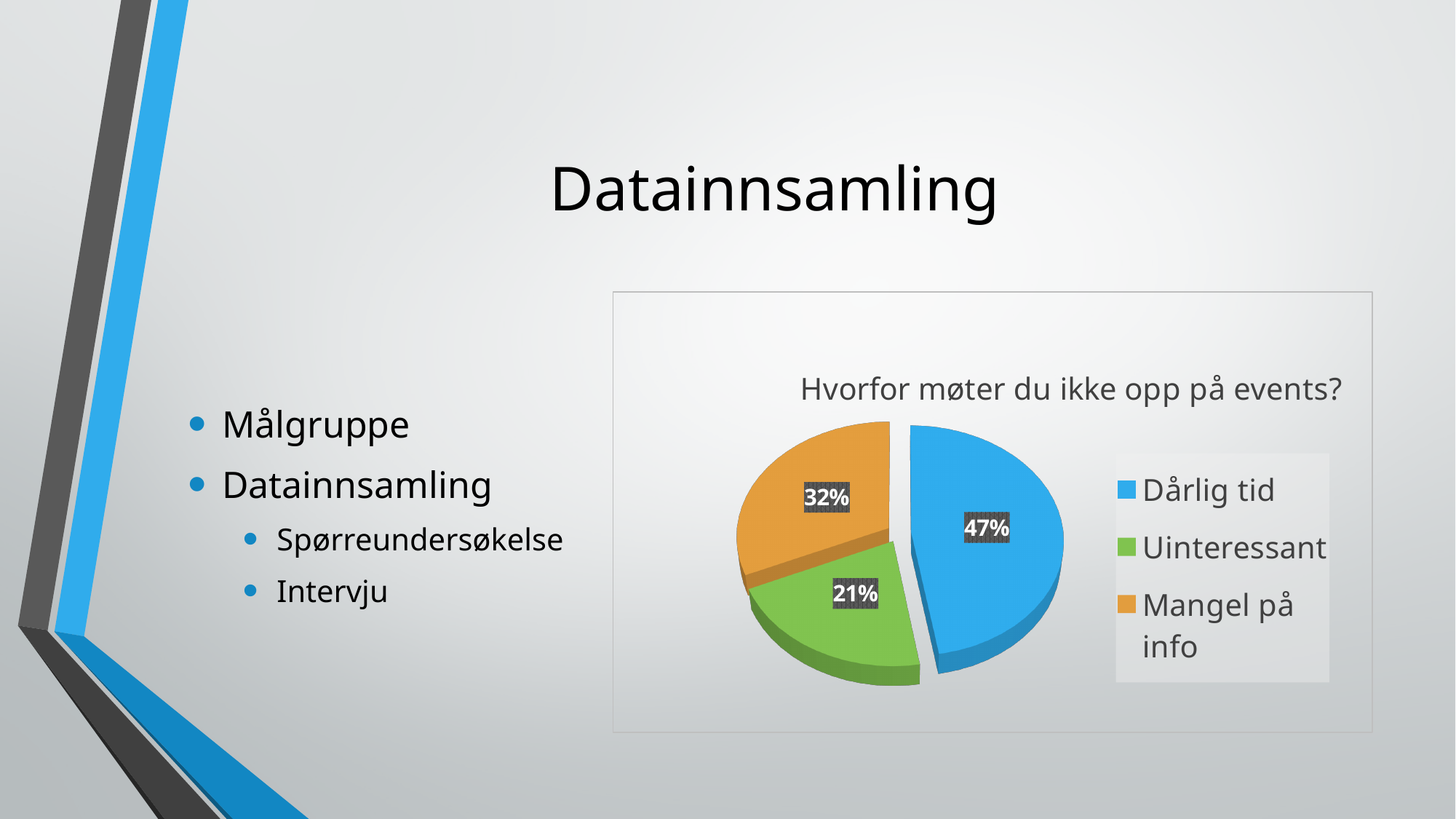
What kind of chart is shown on the slide? Pie chart How many categories does the pie chart show? 3 Which category has the largest share of the pie? Dårlig tid What colour is the slice for Uinteressant? Green What percentage of the pie is labelled for Mangel på info? 32% What percentage of the pie is labelled for Dårlig tid? 47% What percentage of the pie is labelled for Uinteressant? 21% What is the difference in percentage points between Dårlig tid and Mangel på info? 15 How many entries does the legend list? 3 What is the title of the chart? Hvorfor møter du ikke opp på events? Which category has the smallest share of the pie? Uinteressant Which is larger, the share for Mangel på info or the share for Uinteressant? Mangel på info